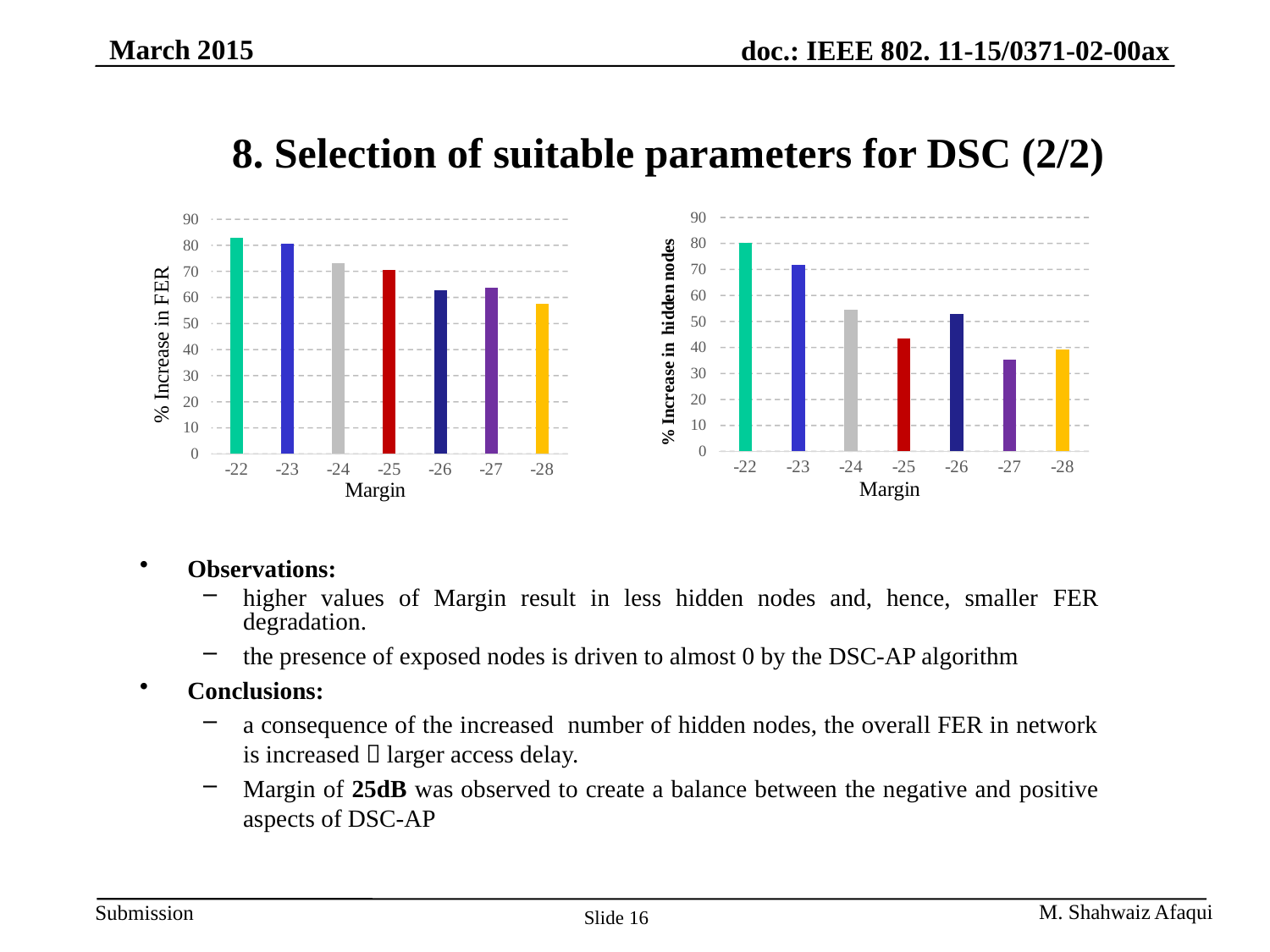
In the right chart (% Increase in hidden nodes), is the value for Margin -27 greater or less than 40? less In the left chart (% Increase in FER), which Margin value has the lowest bar? -28 In the left chart (% Increase in FER), which is larger, the value for Margin -24 or Margin -26? -24 In the right chart (% Increase in hidden nodes), do the values generally rise or fall as Margin goes from -22 to -28? fall What kind of chart is the left chart (% Increase in FER)? bar chart In the right chart (% Increase in hidden nodes), is the value for Margin -22 greater or less than 70? greater In the left chart (% Increase in FER), is the value for Margin -25 greater or less than 60? greater In the right chart (% Increase in hidden nodes), which Margin value has the highest bar? -22 What is the y-axis title of the right chart? % Increase in hidden nodes In the right chart (% Increase in hidden nodes), which Margin value has the lowest bar? -27 In the left chart (% Increase in FER), how many Margin categories are shown on the x axis? 7 In the right chart (% Increase in hidden nodes), which is larger, the value for Margin -24 or Margin -25? -24